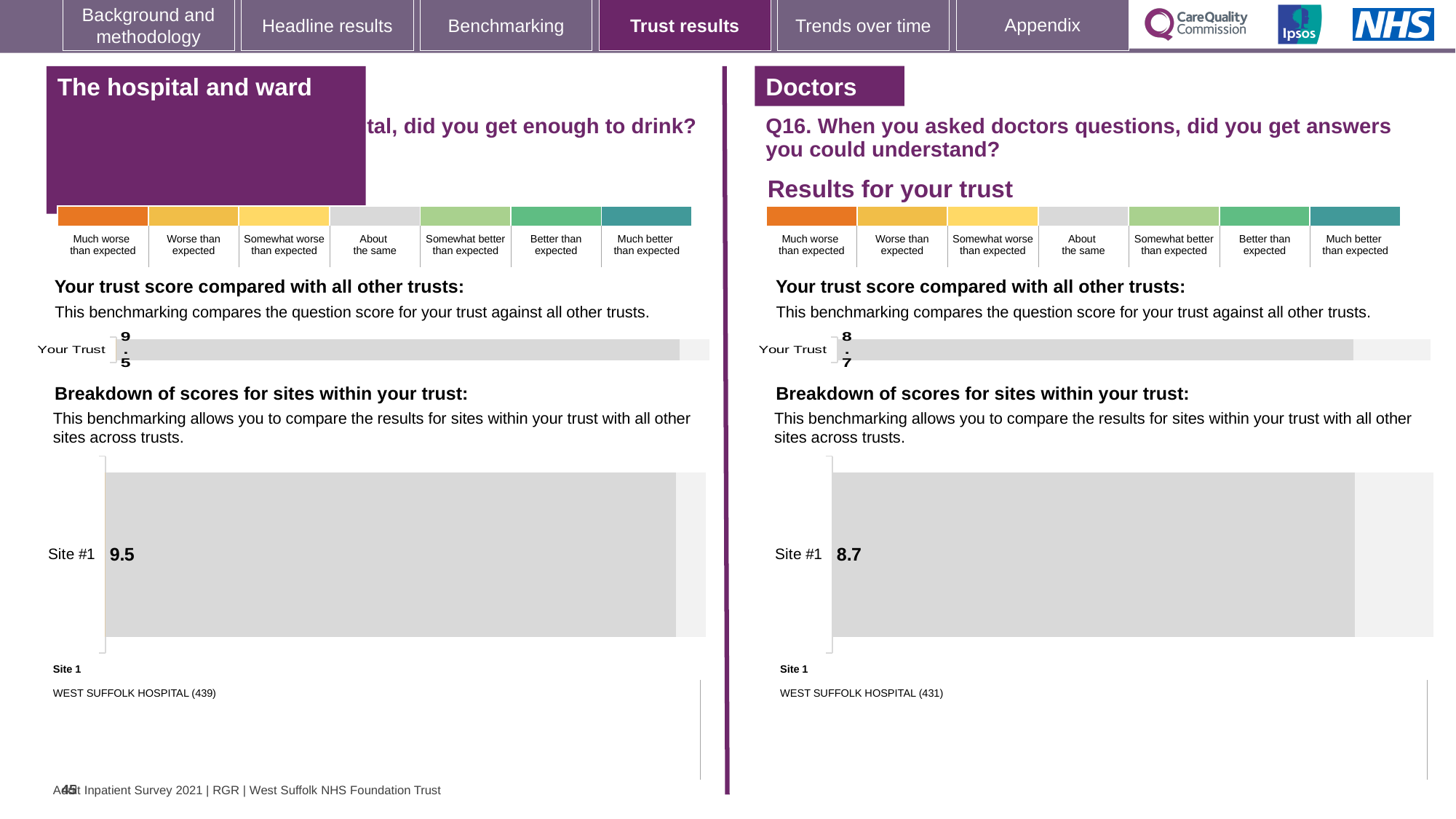
What kind of chart is used to show the Your Trust score in each panel? Bar chart On the right panel (Q16, doctors' answers you could understand), what is the score shown for Your Trust? 8.7 How many sites are shown in the right panel's breakdown of scores for sites within your trust? 1 In the left panel's breakdown of scores for sites, what score is shown for Site #1? 9.5 How many benchmarking categories are shown in the colour key above each chart, from 'Much worse than expected' to 'Much better than expected'? 7 On the left panel (the 'did you get enough to drink?' question), what is the score shown for Your Trust? 9.5 Which site is listed as Site 1 in the right panel (Q16)? WEST SUFFOLK HOSPITAL (431) What is the difference between the Your Trust score on the left panel and the Your Trust score on the right panel (Q16)? 0.8 How many sites are shown in the left panel's breakdown of scores for sites within your trust? 1 Which panel shows the higher trust score: the left panel (enough to drink) or the right panel (Q16, doctors)? Left panel (enough to drink) In the right panel's breakdown of scores for sites, what score is shown for Site #1? 8.7